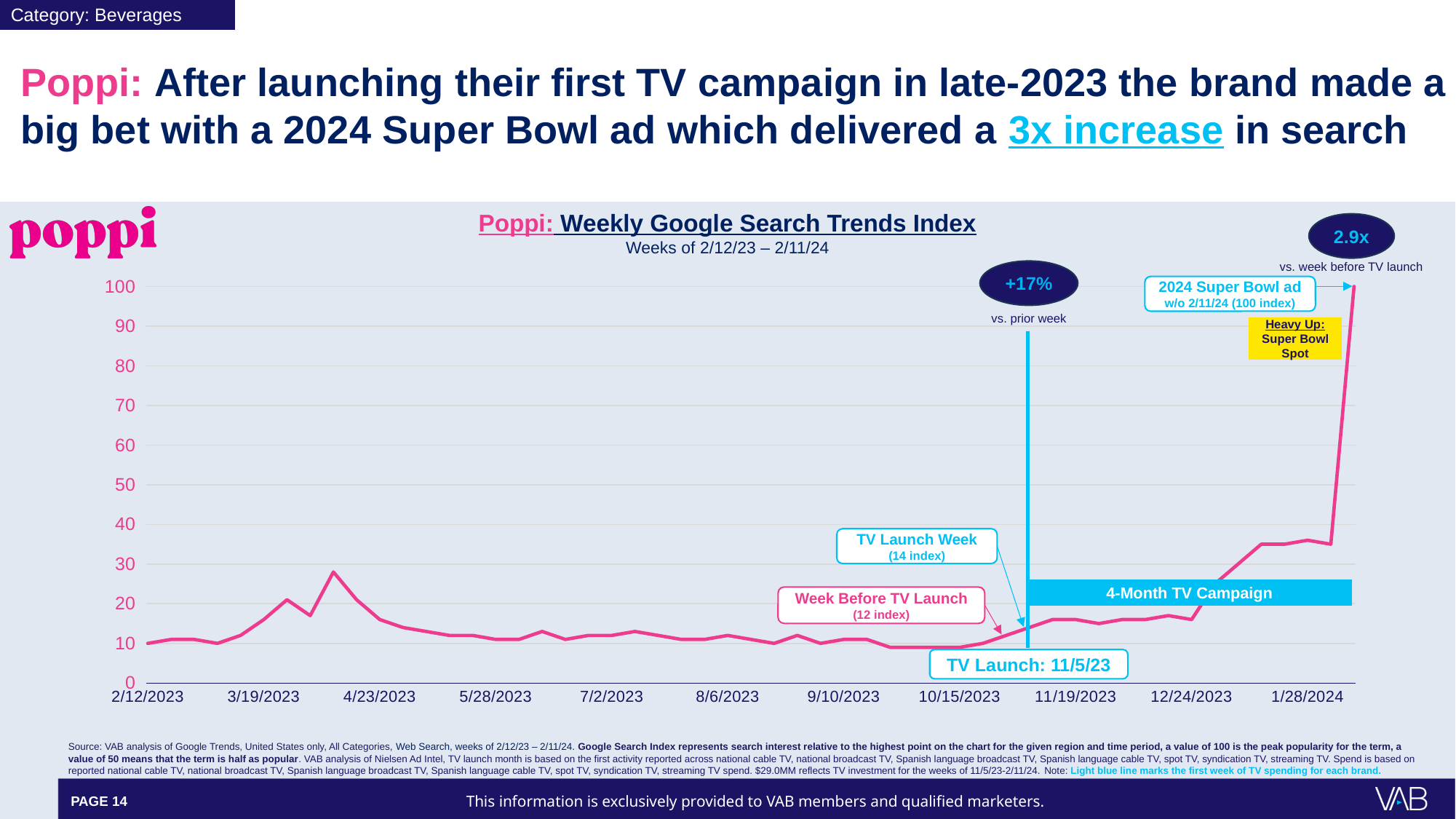
How many date labels are shown on the x axis? 11 What was the search index value in the week of the 2024 Super Bowl ad (w/o 2/11/24)? 100 What is the difference between the Super Bowl ad week index and the week before TV launch index? 88 Which week has the highest search index value on the chart? w/o 2/11/24 (2024 Super Bowl ad week) Which is larger, the index in the TV Launch Week or the index in the week before TV launch? TV Launch Week What was the search index value in the TV Launch Week? 14 What was the search index value in the week before the TV launch? 12 What was the percentage change in search index in the TV launch week vs the prior week, as annotated on the chart? +17% Is the search index value at 2/12/2023 greater or less than 20? less What is the title of the chart? Poppi: Weekly Google Search Trends Index Is the search index value at 1/28/2024 greater or less than 30? greater What kind of chart is shown on the slide? line chart